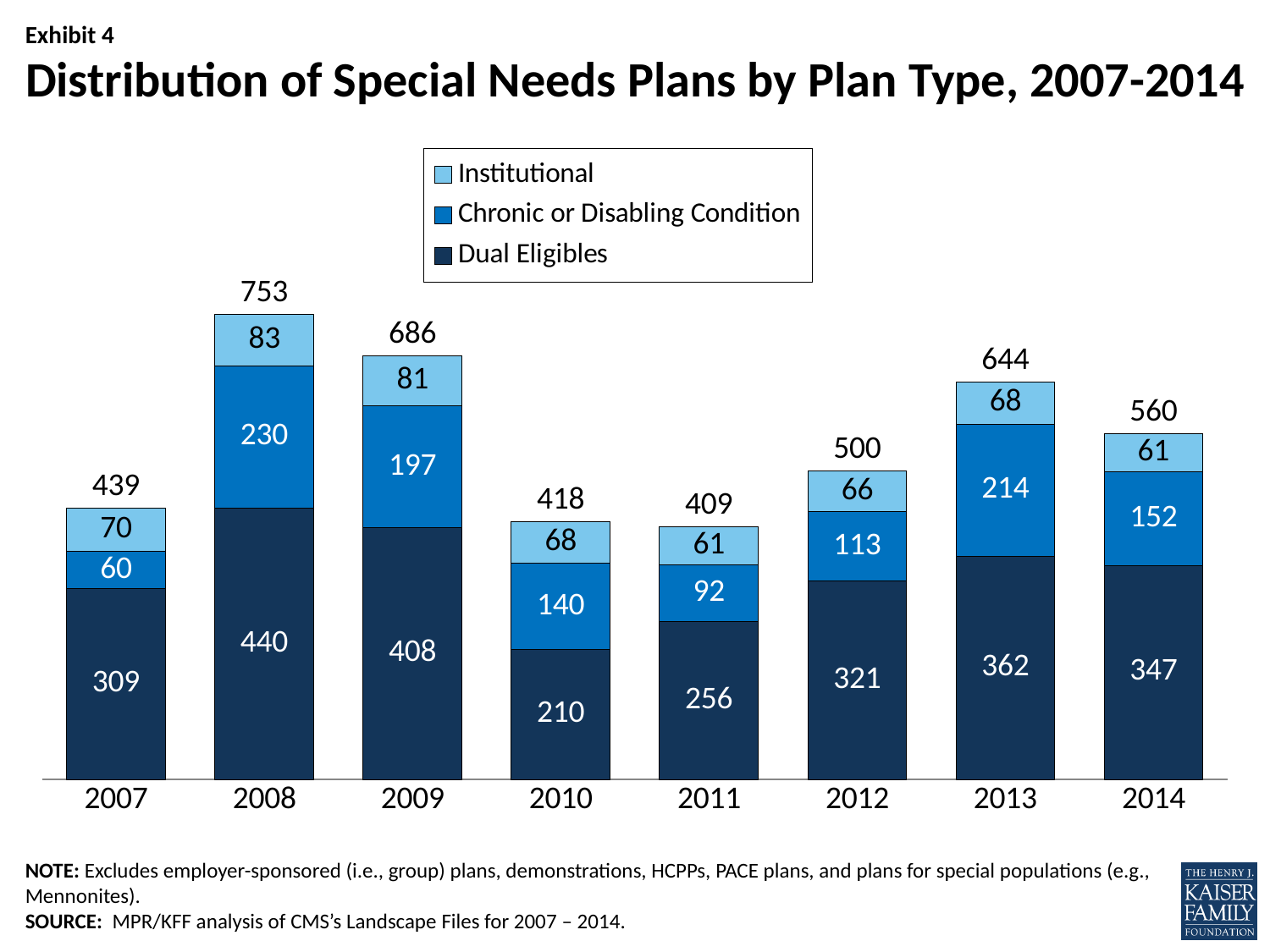
What is the number of Dual Eligibles plans in 2008? 440 How many series does the legend list? 3 Which is larger, the number of Chronic or Disabling Condition plans in 2010 or in 2014? 2014 Which year has the highest total number of special needs plans? 2008 What is the number of Institutional plans in 2011? 61 What is the difference between the total number of plans in 2008 and in 2009? 67 How many years are shown on the x axis? 8 Which year has the lowest total number of special needs plans? 2011 What is the number of Chronic or Disabling Condition plans in 2013? 214 Does the total number of plans rise or fall from 2008 to 2011? Fall What is the total number of special needs plans in 2012? 500 What kind of chart is shown on the slide? Stacked bar chart